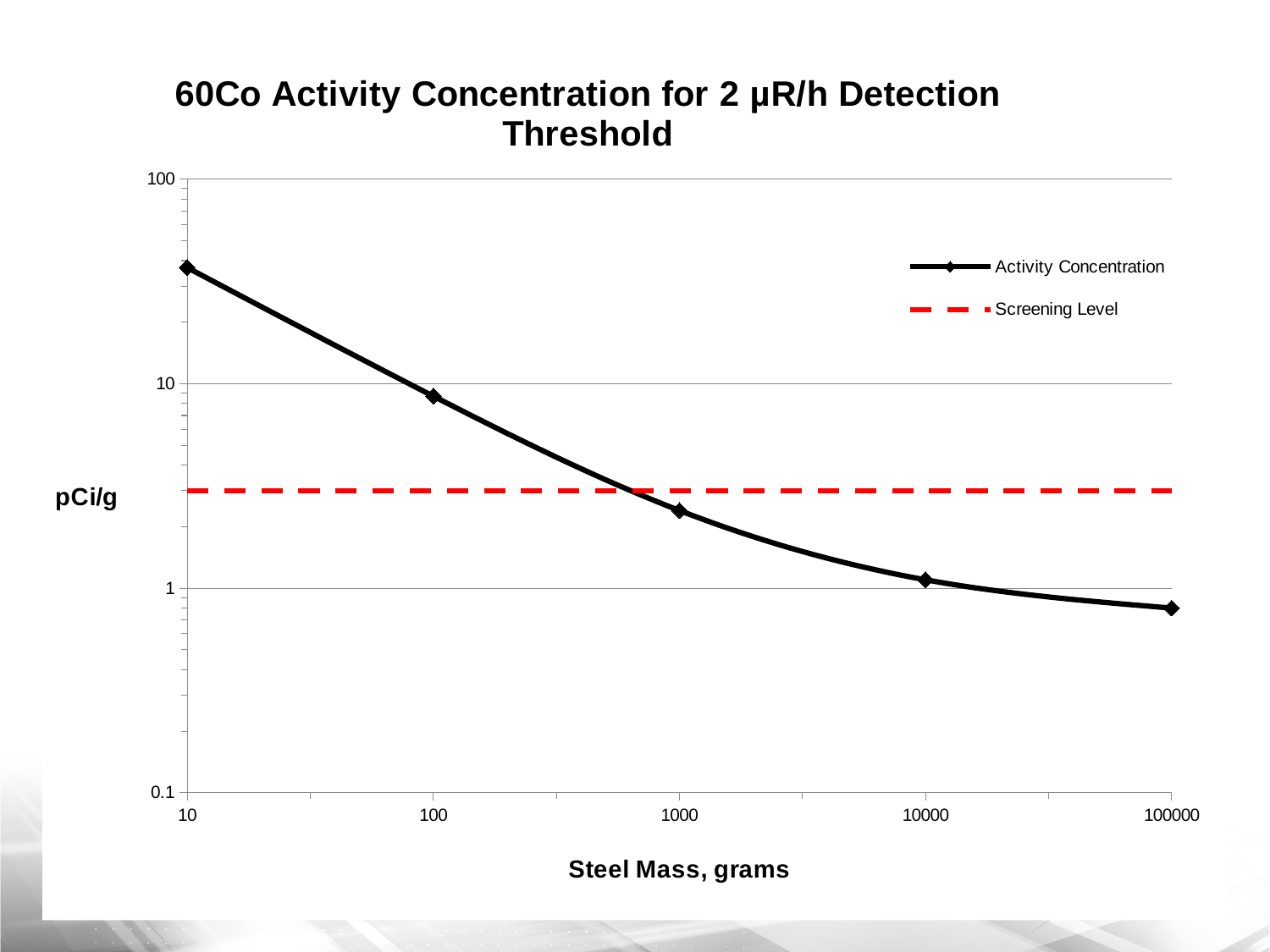
Is the Activity Concentration at a Steel Mass of 1000 grams greater or less than 1 pCi/g? greater Does the Activity Concentration rise or fall as Steel Mass increases along the x axis? fall Is the Activity Concentration at a Steel Mass of 10 grams greater or less than 10 pCi/g? greater What is the label of the x axis? Steel Mass, grams At which Steel Mass is the Activity Concentration highest? 10 What is the title of the chart? 60Co Activity Concentration for 2 μR/h Detection Threshold How many series does the legend list? 2 How many data points are plotted on the Activity Concentration line? 5 At which Steel Mass is the Activity Concentration lowest? 100000 What kind of chart is shown on the slide? line chart Which has the larger Activity Concentration: a Steel Mass of 100 grams or 10000 grams? 100 grams Is the Activity Concentration at a Steel Mass of 1000 grams greater or less than 10 pCi/g? less